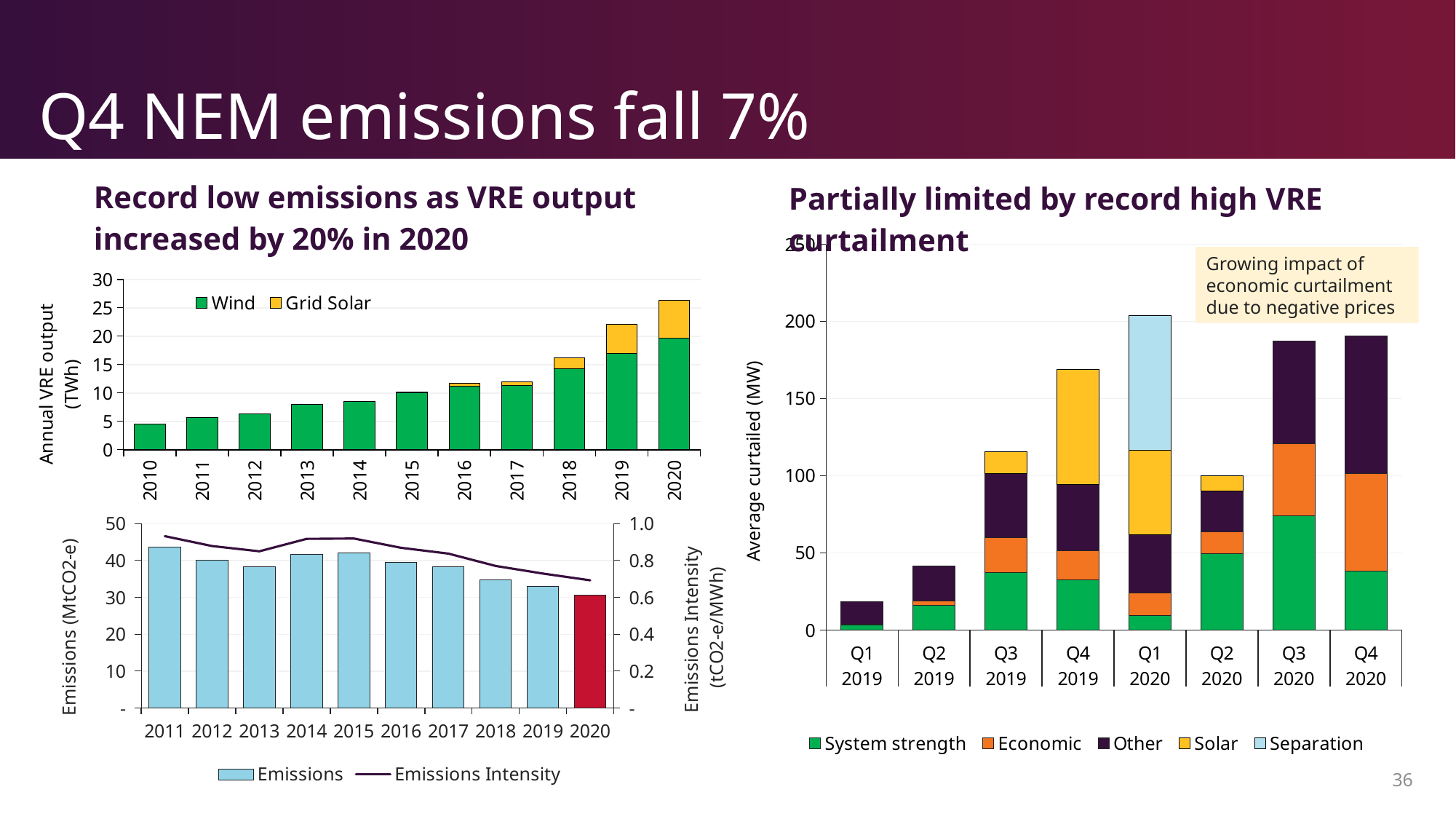
In the Emissions chart at the bottom left, which year's bar is coloured red? 2020 In the Annual VRE output chart, which year has the highest total output? 2020 In the Average curtailed (MW) chart on the right, which quarter has the lowest total curtailment? Q1 2019 What kind of chart is the Annual VRE output chart on the left? bar chart In the Annual VRE output chart, is the total value for 2019 greater or less than 20? greater In the Annual VRE output chart, do the values rise or fall from 2010 to 2020? rise In the Emissions chart at the bottom left, which year has the lowest emissions? 2020 How many series does the legend of the Annual VRE output chart list? 2 In the Emissions chart at the bottom left, is the emissions value for 2019 greater or less than 40? less How many years are shown on the x axis of the Annual VRE output chart? 11 How many series does the legend of the Average curtailed (MW) chart on the right list? 5 In the Average curtailed (MW) chart on the right, is the total for Q3 2020 greater or less than 150? greater